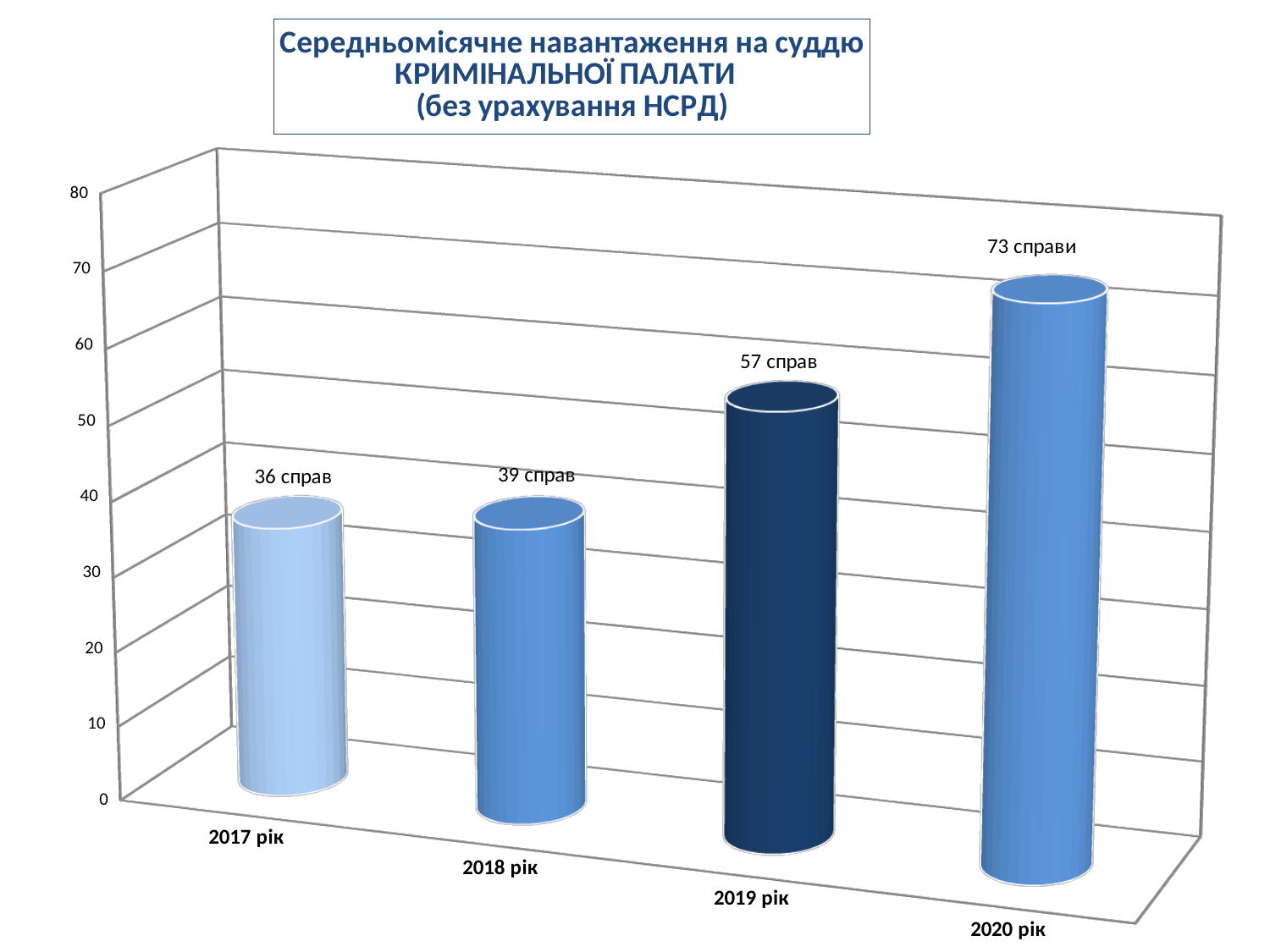
What is the value for 2017 рік? 36 справ Which year has the highest value? 2020 рік What is the value for 2019 рік? 57 справ What is the difference between the values for 2018 рік and 2017 рік? 3 Which is larger, the value for 2019 рік or the value for 2018 рік? 2019 рік How many years are shown on the chart? 4 Which year has the lowest value? 2017 рік What is the value for 2018 рік? 39 справ What is the difference between the values for 2020 рік and 2019 рік? 16 What kind of chart is this? bar chart What is the value for 2020 рік? 73 справи Do the values rise or fall from 2017 рік to 2020 рік? rise